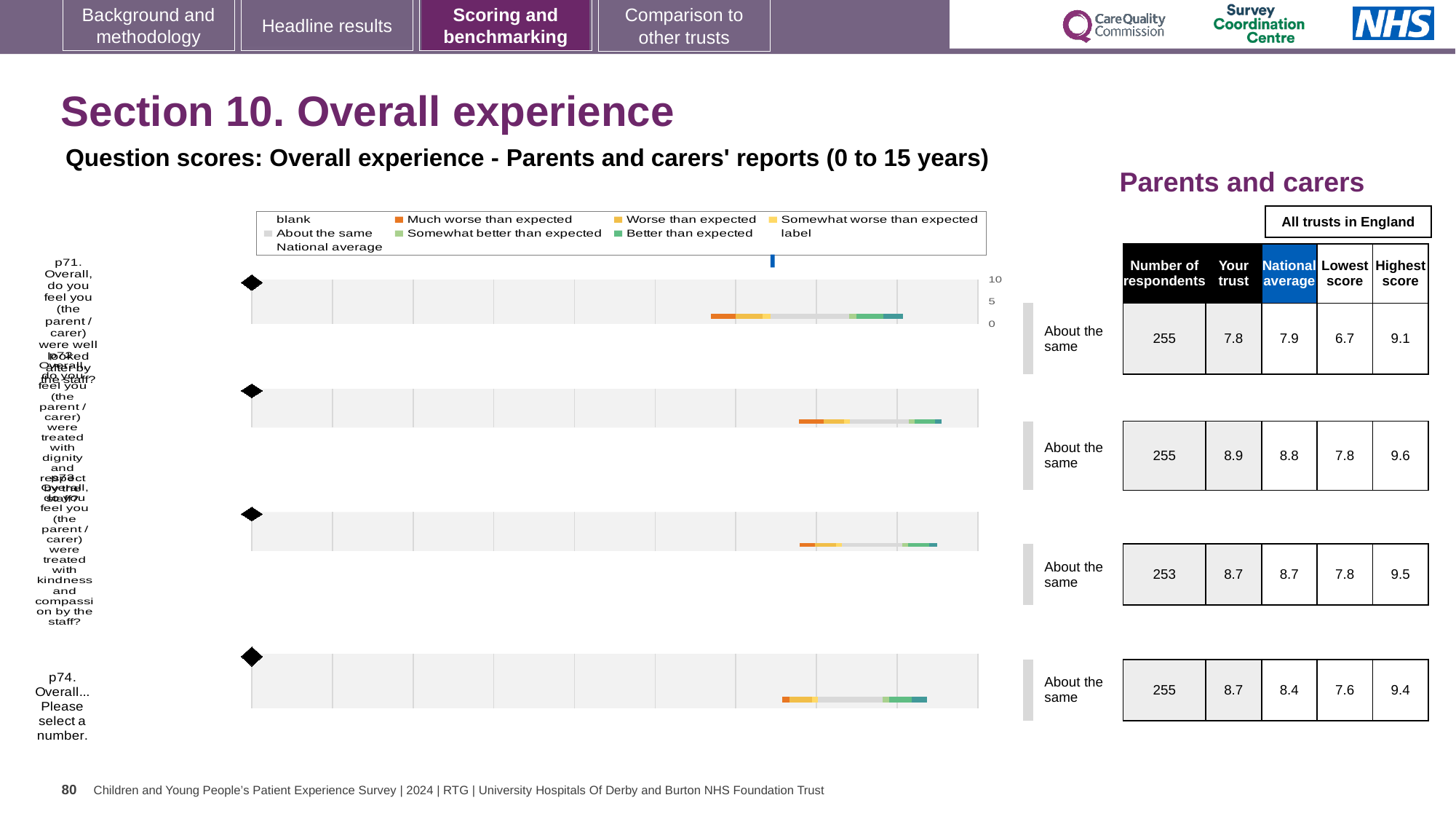
In the table, what is the highest score for the second row (p72)? 9.6 Which legend entry is shown in orange? Much worse than expected How many question rows (bars) are plotted in the chart? 4 Which row has the highest 'Your trust' score in the table? p72 (second row) In the table, what is the number of respondents for the last row (p74. Overall... Please select a number)? 255 What is the title of the chart section above the bars? Question scores: Overall experience - Parents and carers' reports (0 to 15 years) Which row has the lowest 'Your trust' score in the table? p71 (first row) For the last row (p74), what is the difference between the 'Your trust' score and the national average? 0.3 In the table, what is the 'Your trust' score for the second row (p72)? 8.9 In the table, what is the lowest score for the first row (p71)? 6.7 In the table, what is the national average for the last row (p74)? 8.4 What kind of chart is shown on the slide? bar chart